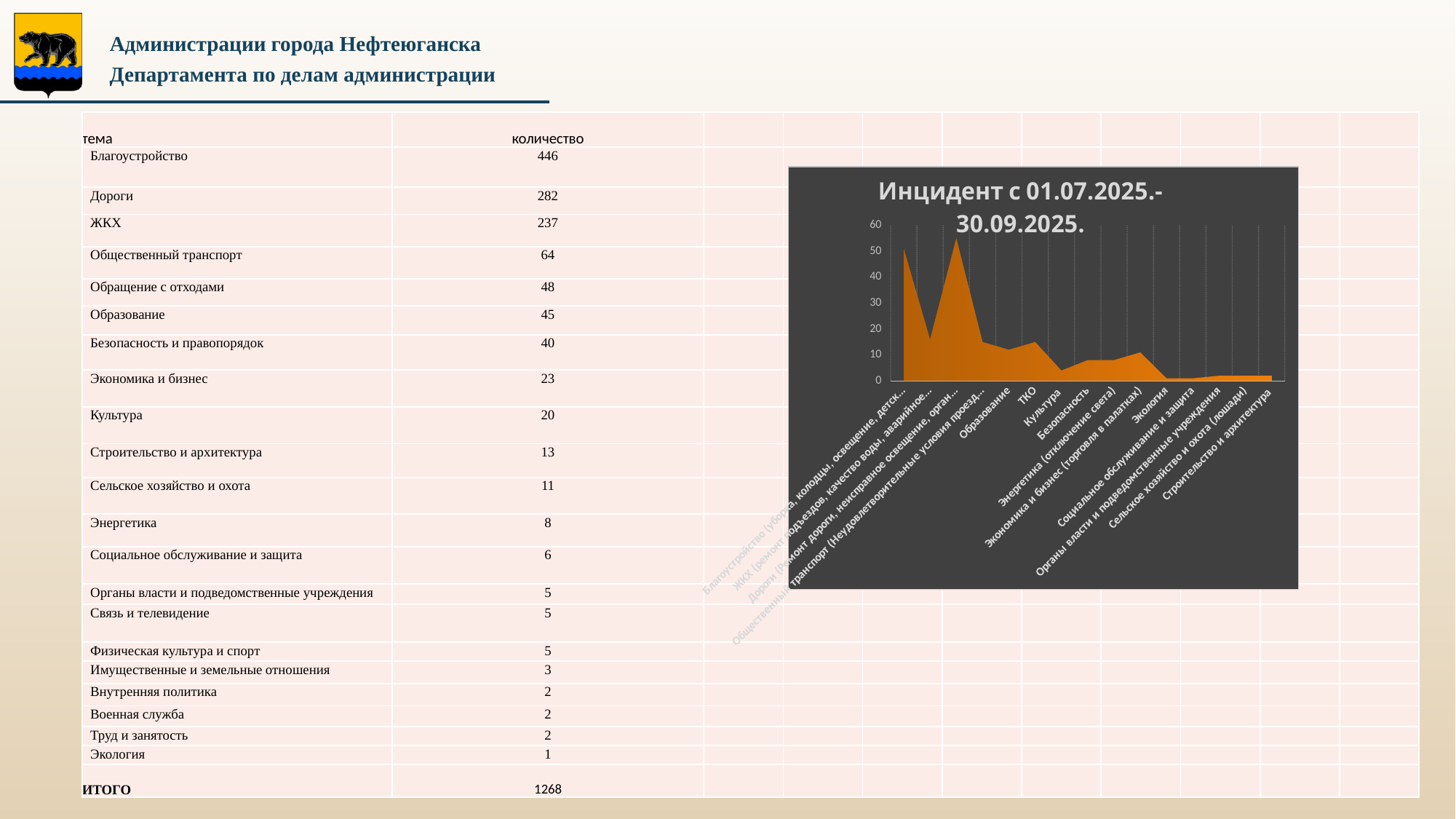
Is the value for Дороги in the chart greater or less than 50? greater Is the value for ЖКХ in the chart greater or less than 20? less In the chart, which is larger: the value for Благоустройство or the value for ЖКХ? Благоустройство Is the value for Экология in the chart greater or less than 10? less What is the highest tick value shown on the chart's vertical axis? 60 Which category has the highest value in the chart? Дороги (ремонт дороги, неисправное освещение, орган...) What is the title of the chart? Инцидент с 01.07.2025.-30.09.2025. Do the values in the chart generally rise or fall from left to right along the x axis? fall What kind of chart is shown on the slide? area chart How many categories are plotted along the x axis of the chart? 15